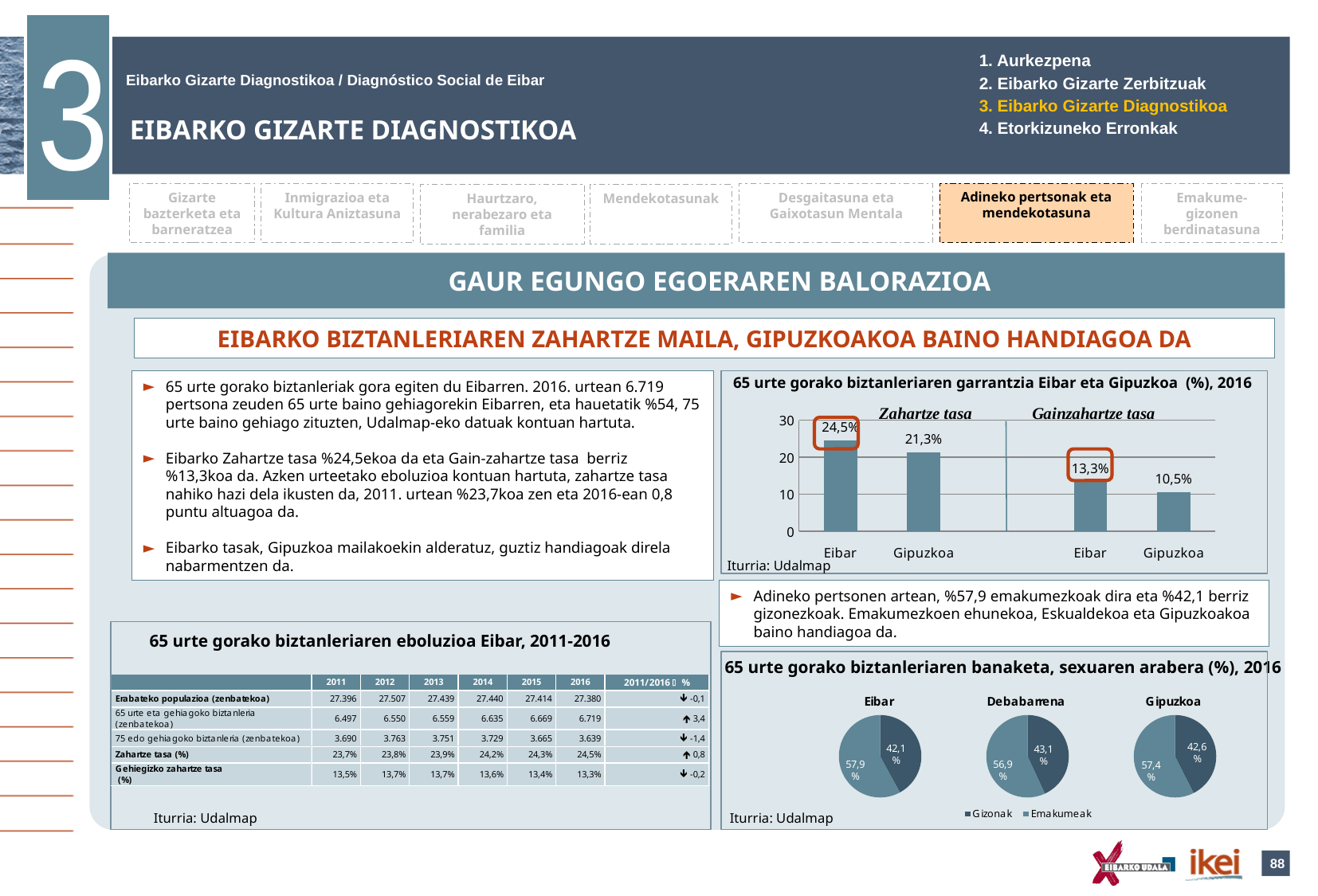
In the bar chart titled "65 urte gorako biztanleriaren garrantzia Eibar eta Gipuzkoa (%), 2016", what is the difference between the Zahartze tasa of Eibar and Gipuzkoa? 3,2 percentage points In the bar chart titled "65 urte gorako biztanleriaren garrantzia Eibar eta Gipuzkoa (%), 2016", which bar is the lowest? Gipuzkoa (Gainzahartze tasa) In the bar chart titled "65 urte gorako biztanleriaren garrantzia Eibar eta Gipuzkoa (%), 2016", how many bars are plotted? 4 In the bar chart titled "65 urte gorako biztanleriaren garrantzia Eibar eta Gipuzkoa (%), 2016", what is the Zahartze tasa value for Eibar? 24,5% In the bar chart titled "65 urte gorako biztanleriaren garrantzia Eibar eta Gipuzkoa (%), 2016", which bar is the highest? Eibar (Zahartze tasa) In the bar chart titled "65 urte gorako biztanleriaren garrantzia Eibar eta Gipuzkoa (%), 2016", is the Gainzahartze tasa for Eibar greater or less than 10? greater In the pie charts titled "65 urte gorako biztanleriaren banaketa, sexuaren arabera (%), 2016", what is the share of Emakumeak in Eibar? 57,9% In the pie charts titled "65 urte gorako biztanleriaren banaketa, sexuaren arabera (%), 2016", what is the share of Gizonak in Debabarrena? 43,1% What kind of chart is the one titled "65 urte gorako biztanleriaren garrantzia Eibar eta Gipuzkoa (%), 2016"? Bar chart How many series does the legend of the pie charts titled "65 urte gorako biztanleriaren banaketa, sexuaren arabera (%), 2016" list? 2 In the bar chart titled "65 urte gorako biztanleriaren garrantzia Eibar eta Gipuzkoa (%), 2016", what is the Gainzahartze tasa value for Gipuzkoa? 10,5% In the pie charts titled "65 urte gorako biztanleriaren banaketa, sexuaren arabera (%), 2016", which region has the highest share of Emakumeak? Eibar